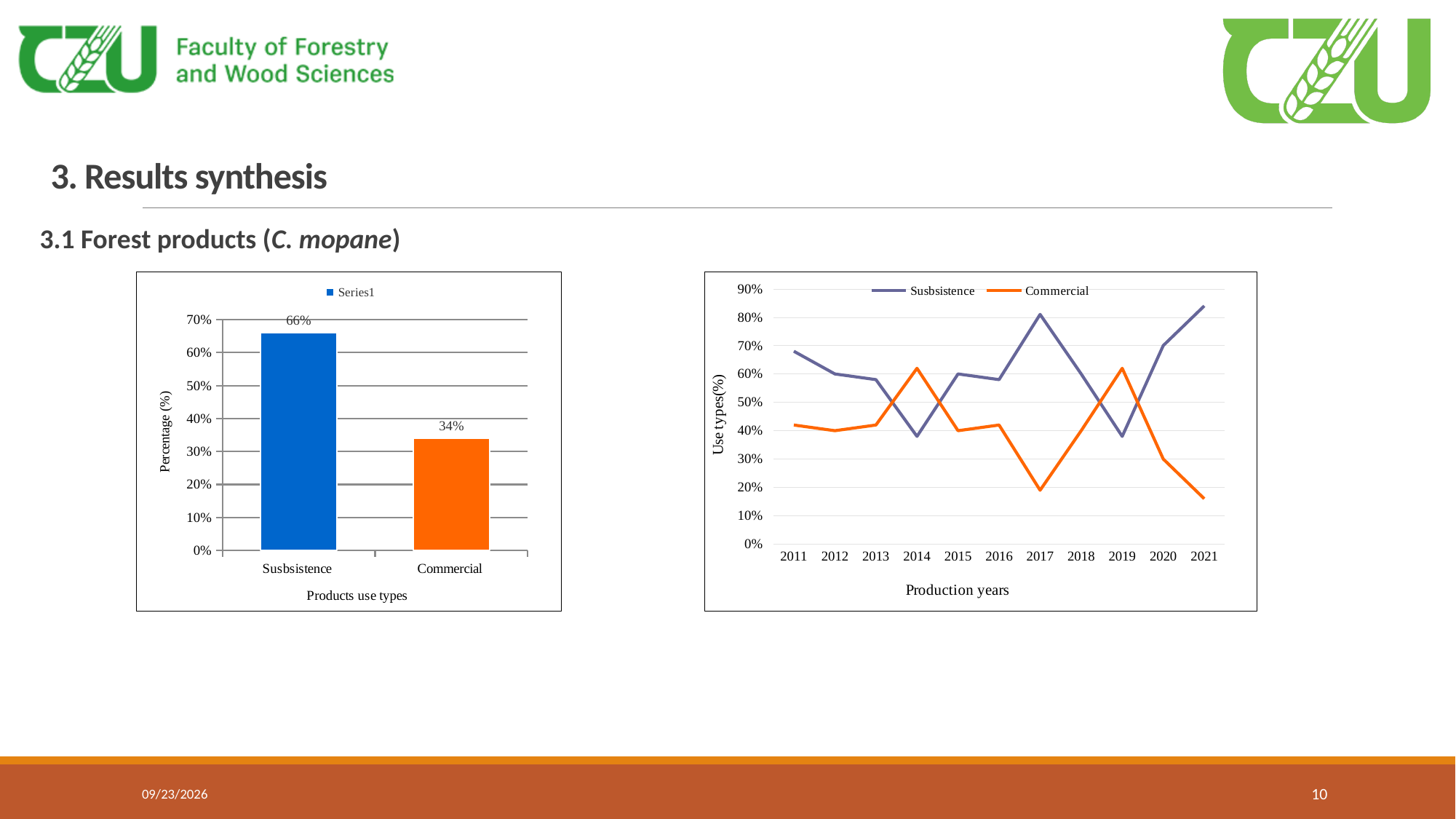
In the right line chart, how many production years are shown on the x axis? 11 In the right line chart, is the Susbsistence value for 2021 greater or less than 80%? greater What kind of chart is the chart on the right? Line chart In the left bar chart, what is the value for Susbsistence? 66% In the left bar chart, how many product use types are shown on the x axis? 2 What kind of chart is the chart on the left? Bar chart In the left bar chart, what is the value for Commercial? 34% In the right line chart, is the Commercial value for 2017 greater or less than 30%? less In the left bar chart, which product use type has the higher percentage? Susbsistence In the right line chart, which series has the larger value in 2019, Susbsistence or Commercial? Commercial In the left bar chart, what is the difference between the Susbsistence and Commercial percentages? 32% In the right line chart, how many series does the legend list? 2